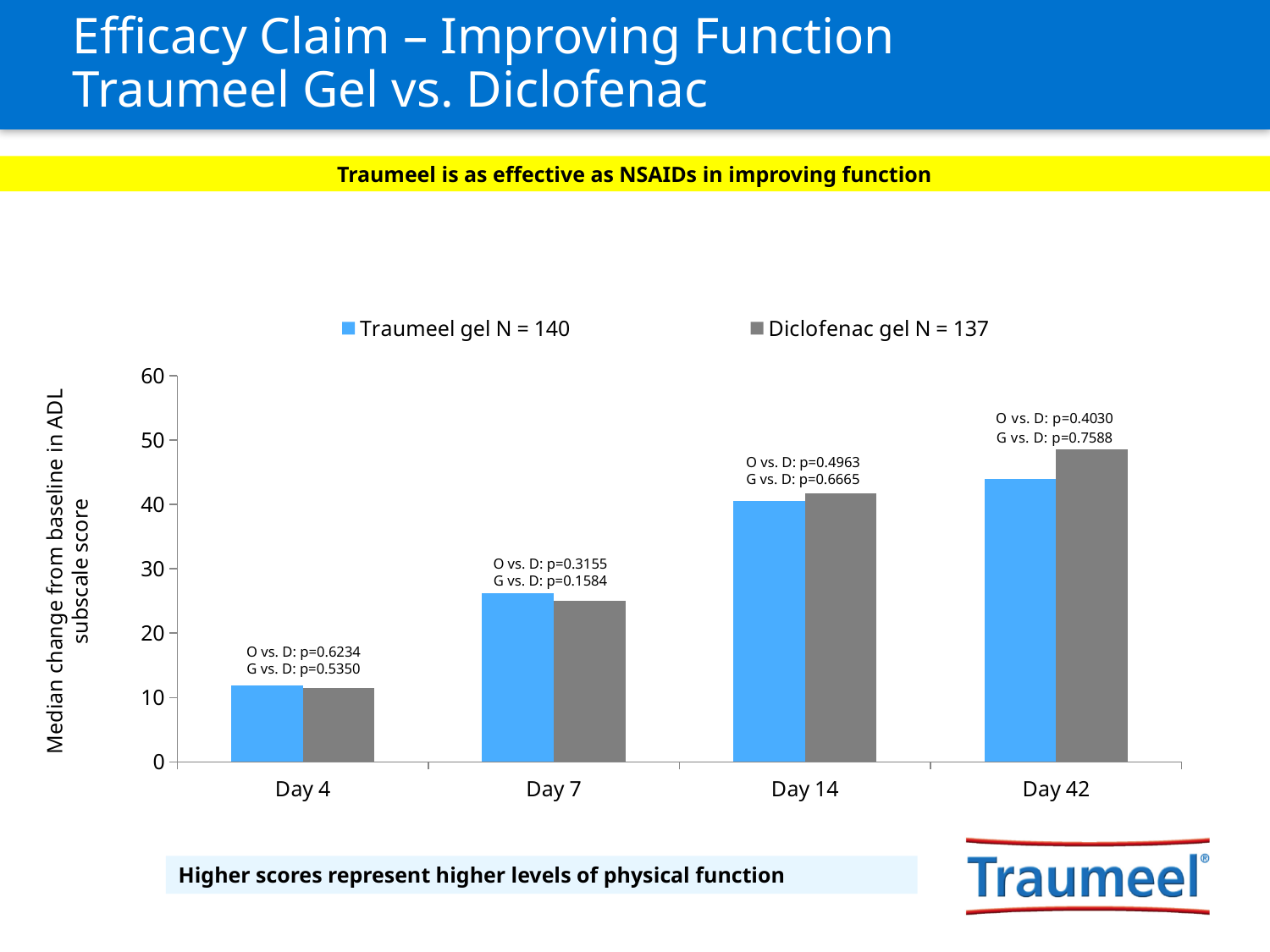
Is the value for Diclofenac gel at Day 7 greater or less than 30? less At which time point is the Traumeel gel bar the lowest? Day 4 What p-value is printed for O vs. D at Day 42? p=0.4030 Is the value for Diclofenac gel at Day 42 greater or less than 50? less How many time points (categories) are shown on the x axis? 4 What kind of chart is shown on the slide? bar chart Is the value for Traumeel gel at Day 4 greater or less than 10? greater Which series and time point has the highest bar in the chart? Diclofenac gel at Day 42 How many series does the legend list? 2 At Day 42, which is larger: the Traumeel gel value or the Diclofenac gel value? Diclofenac gel Do the Traumeel gel values rise or fall from Day 4 to Day 42? rise What is the label on the y axis of the chart? Median change from baseline in ADL subscale score